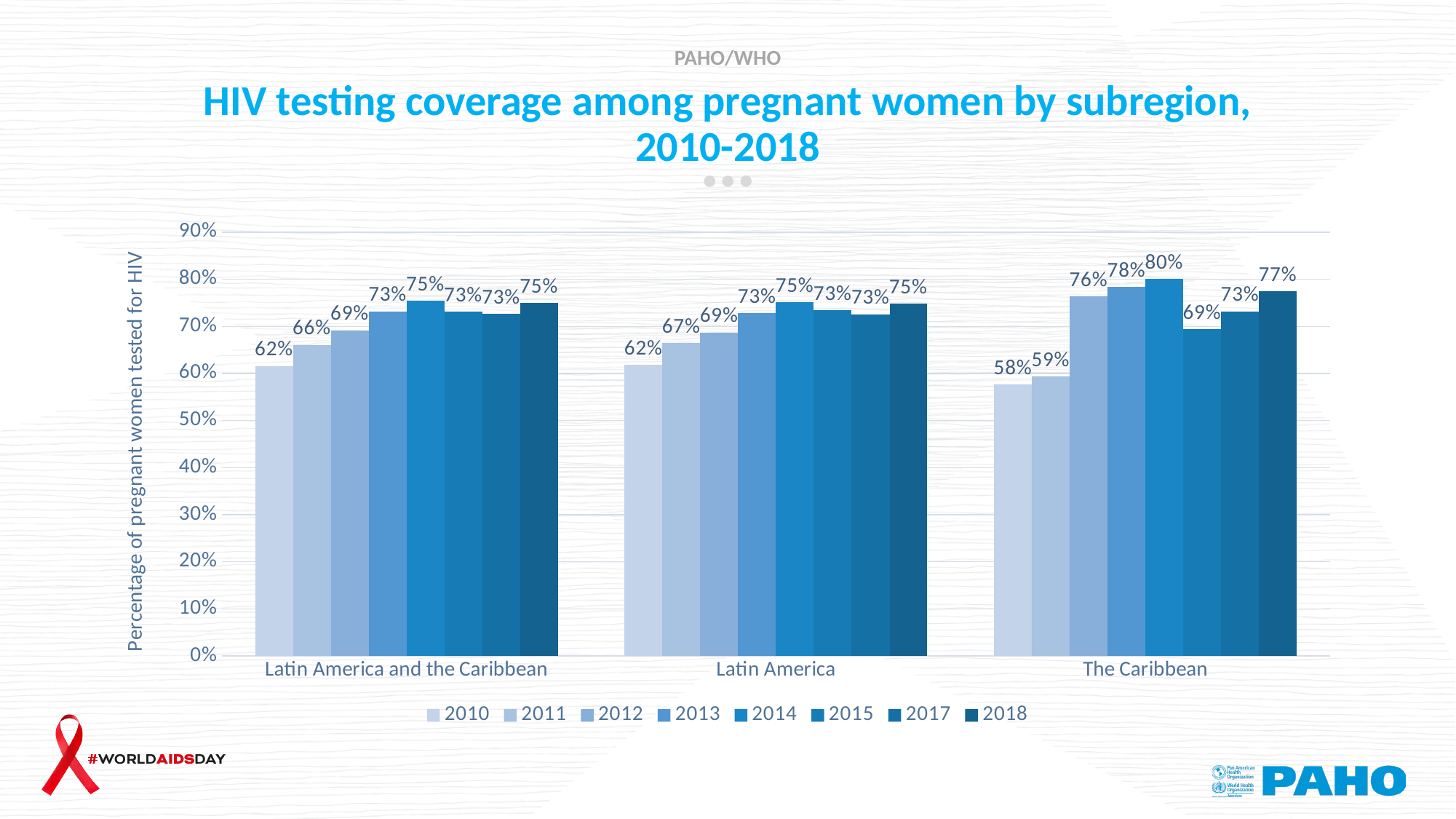
What is the value for Latin America and the Caribbean in 2010? 62% How many series does the legend list? 8 What is the value for Latin America in 2011? 67% What is the HIV testing coverage for The Caribbean in 2014? 80% How many subregions are shown on the x axis? 3 What kind of chart is shown on the slide? Bar chart Did the value for Latin America and the Caribbean rise or fall from 2010 to 2014? Rise Which is larger: The Caribbean in 2012 or Latin America in 2012? The Caribbean in 2012 What is the label of the vertical axis? Percentage of pregnant women tested for HIV Which subregion has the lowest value in 2010? The Caribbean Which subregion has the highest value in 2018? The Caribbean What is the difference between The Caribbean's 2014 value and its 2015 value? 11%